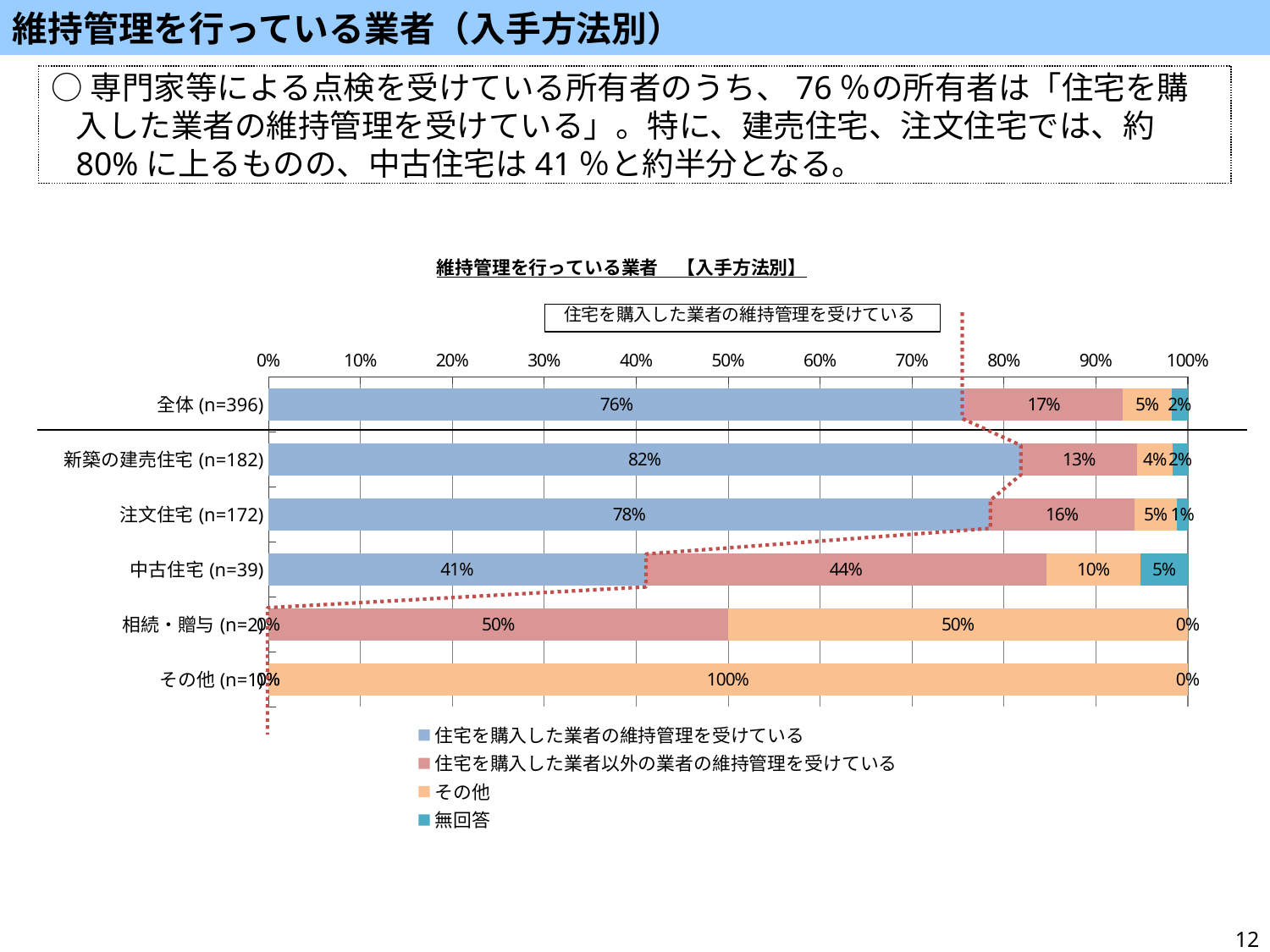
What is the value of 住宅を購入した業者の維持管理を受けている for 新築の建売住宅 (n=182)? 82% What is the value of その他 for その他 (n=1)? 100% Which category has the highest value for 無回答? 中古住宅 (n=39) What is the value of 住宅を購入した業者以外の業者の維持管理を受けている for 中古住宅 (n=39)? 44% How many series does the legend list? 4 How many categories are plotted on the y axis? 6 What is the value of 住宅を購入した業者の維持管理を受けている for 全体 (n=396)? 76% Which is larger for 注文住宅 (n=172): 住宅を購入した業者以外の業者の維持管理を受けている or その他? 住宅を購入した業者以外の業者の維持管理を受けている What is the value of その他 for 相続・贈与 (n=2)? 50% What type of chart is shown on the slide? stacked bar chart What is the difference between the 住宅を購入した業者の維持管理を受けている values for 新築の建売住宅 (n=182) and 中古住宅 (n=39)? 41% Which category has the highest value for 住宅を購入した業者の維持管理を受けている? 新築の建売住宅 (n=182)